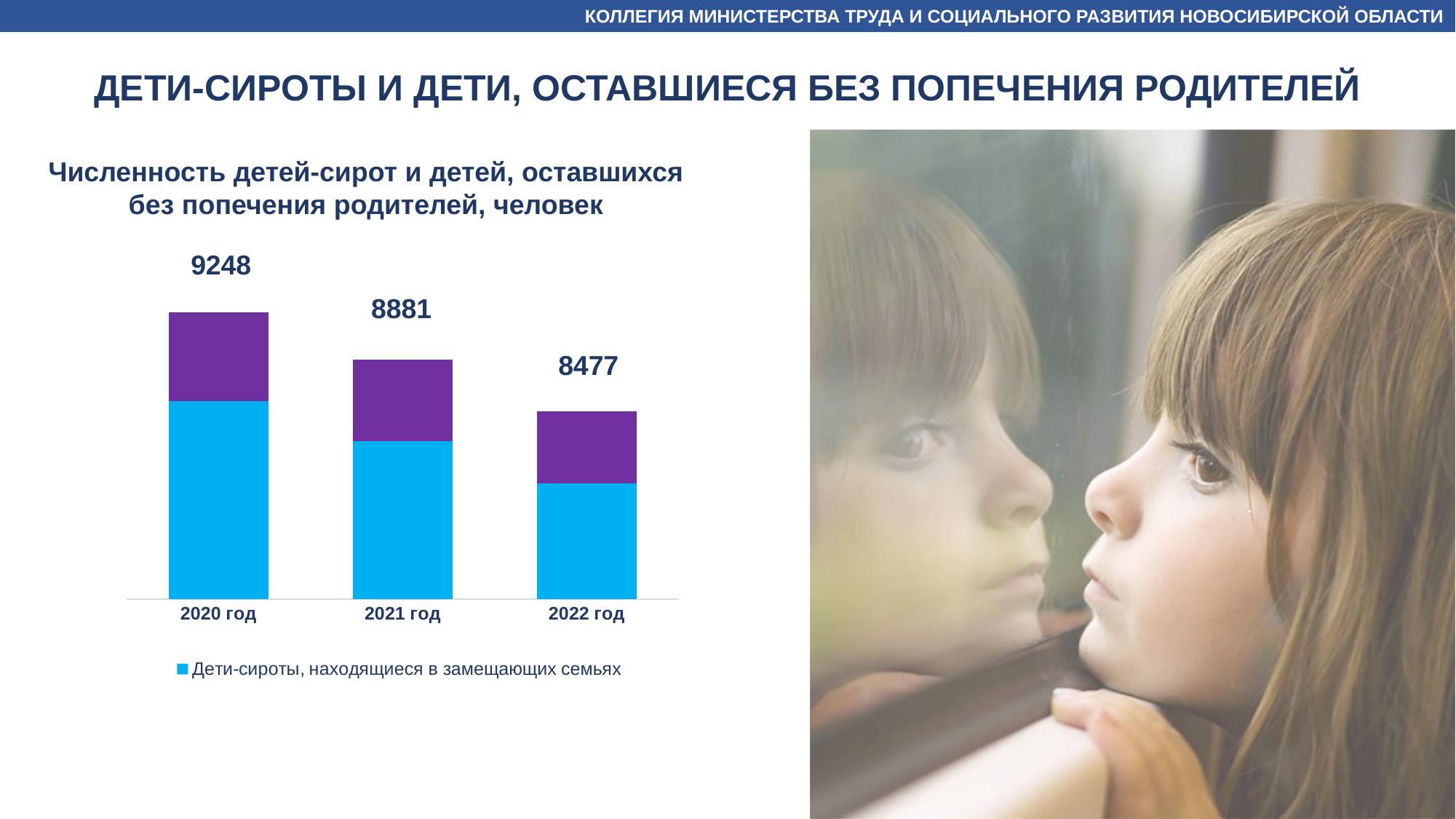
How many years (categories) are shown on the x axis? 3 What series name does the legend list for the blue segments? Дети-сироты, находящиеся в замещающих семьях Which is larger, the total for 2021 год or the total for 2022 год? 2021 год What is the total value shown above the bar for 2020 год? 9248 Do the totals rise or fall from 2020 год to 2022 год? Fall What is the total value shown above the bar for 2022 год? 8477 What is the difference between the totals for 2020 год and 2021 год? 367 What is the total value shown above the bar for 2021 год? 8881 By how much did the total decrease from 2020 год to 2022 год? 771 Which year has the lowest total number of children? 2022 год What kind of chart is shown on the slide? Stacked bar chart Which year has the highest total number of children? 2020 год